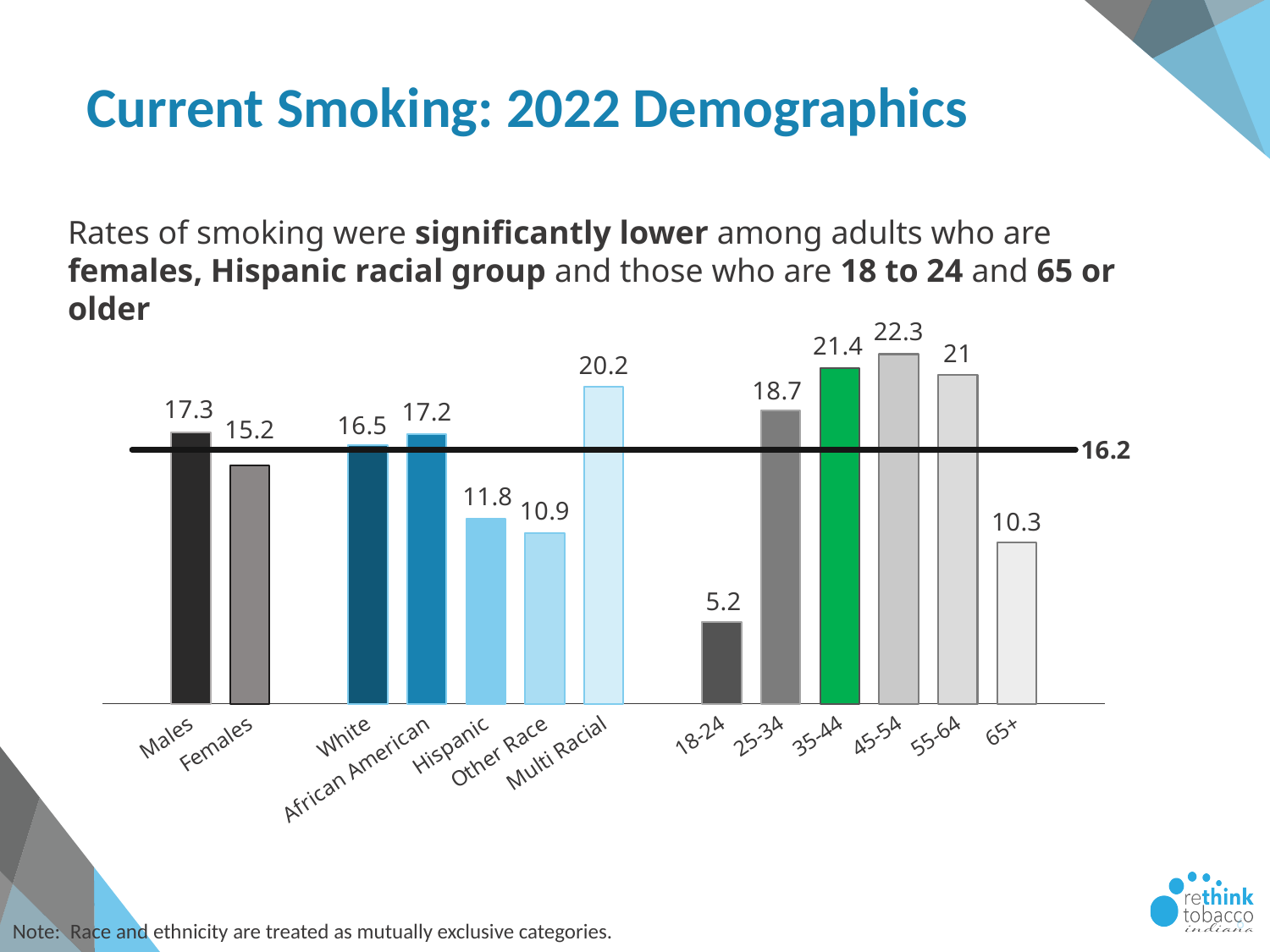
Which category has the highest value on the chart? 45-54 What value is marked by the horizontal reference line across the chart? 16.2 What is the value shown for the Hispanic group? 11.8 What is the difference between the values for Males and Females? 2.1 What is the value shown for the 65+ age group? 10.3 What is the current smoking rate shown for Males? 17.3 How many bars are plotted on the chart? 13 Which category has the lowest value on the chart? 18-24 What is the value shown for the 18-24 age group? 5.2 Which has a higher value, White or African American? African American What is the difference between the values for Multi Racial and Other Race? 9.3 What kind of chart is shown on the slide? Bar chart